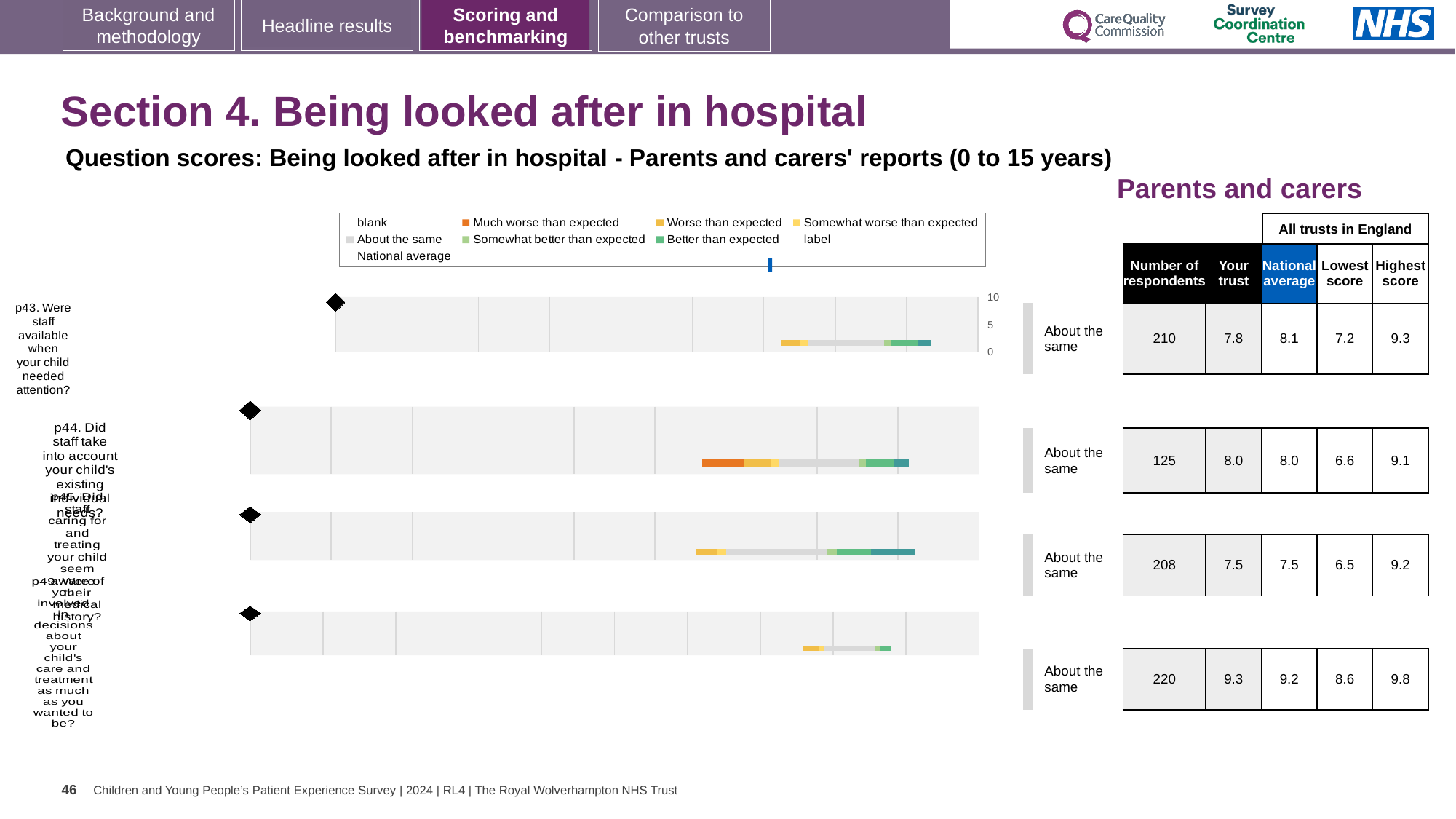
In the legend, which colour represents 'Much worse than expected'? orange For the top chart (p43. Were staff available when your child needed attention?), what is the 'Your trust' score? 7.8 For the second chart from the top (p44), what is the 'Your trust' score? 8.0 What benchmark category is shown next to each of the four charts? About the same For the top chart (p43. Were staff available when your child needed attention?), what is the number of respondents shown in the table? 210 For the bottom chart (p49), what is the number of respondents? 220 Which of the four question charts has the highest 'Your trust' score in the table? the bottom chart (p49), 9.3 For the top chart (p43), what is the difference between the highest score (9.3) and the lowest score (7.2) across all trusts in England? 2.1 What kind of chart is used for the p43 question 'Were staff available when your child needed attention?'? bar chart For the top chart (p43. Were staff available when your child needed attention?), what is the national average score? 8.1 For the top chart (p43), is the 'Your trust' score higher or lower than the national average? lower How many question charts (rows) are shown on the slide? 4